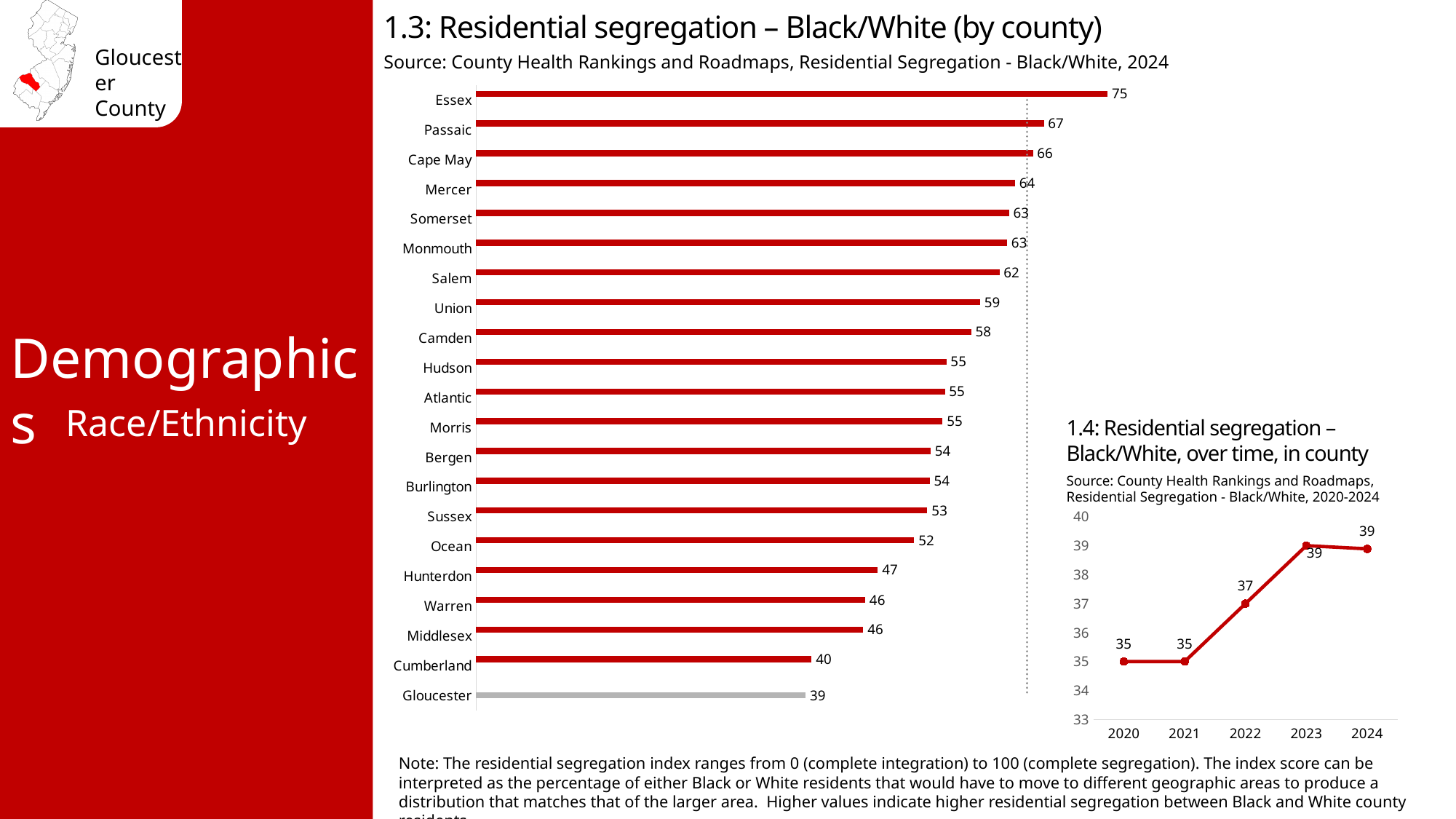
In chart 1.3 (by county), which has the larger value, Passaic or Mercer? Passaic In chart 1.3 (by county), how many counties are shown? 21 In chart 1.3 (by county), what is the value for Camden? 58 What kind of chart is chart 1.3 (by county)? Bar chart In chart 1.4 (over time, in county), what is the value for 2022? 37 In chart 1.4 (over time, in county), do the values rise or fall from 2020 to 2024? Rise In chart 1.3 (by county), which county has the lowest value? Gloucester In chart 1.3 (by county), what is the difference between the values for Essex and Gloucester? 36 In chart 1.4 (over time, in county), how many years are plotted? 5 In chart 1.3 (Residential segregation – Black/White by county), what is the value for Gloucester? 39 In chart 1.3 (by county), which county has the highest value? Essex In chart 1.4 (over time, in county), what is the difference between the values for 2024 and 2020? 4